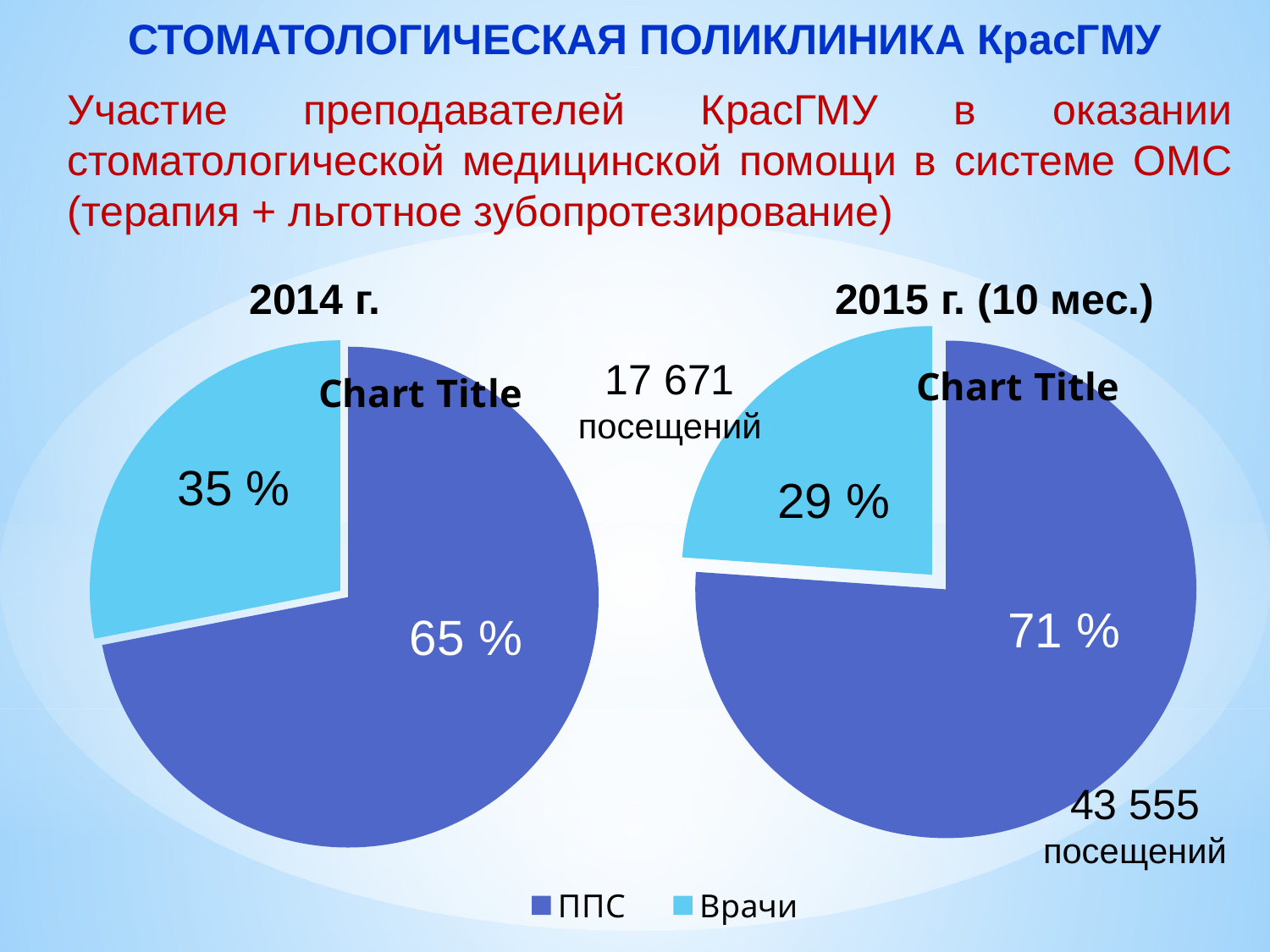
In the 2014 г. pie chart, what share is shown for Врачи? 35 % In the 2014 г. pie chart, which category has the largest slice? ППС How many entries does the shared legend below the charts list? 2 In the 2015 г. (10 мес.) pie chart, what share is shown for ППС? 71 % What kind of chart is used for the 2014 г. and 2015 г. (10 мес.) data? Pie chart In the 2015 г. (10 мес.) pie chart, which category has the smallest slice? Врачи According to the legend, which colour represents Врачи? Light blue Is the Врачи share larger in the 2014 г. chart or in the 2015 г. (10 мес.) chart? 2014 г. How many slices does the 2015 г. (10 мес.) pie chart have? 2 In the 2014 г. pie chart, by how many percentage points does the ППС share exceed the Врачи share? 30 percentage points In the 2015 г. (10 мес.) pie chart, what share is shown for Врачи? 29 %